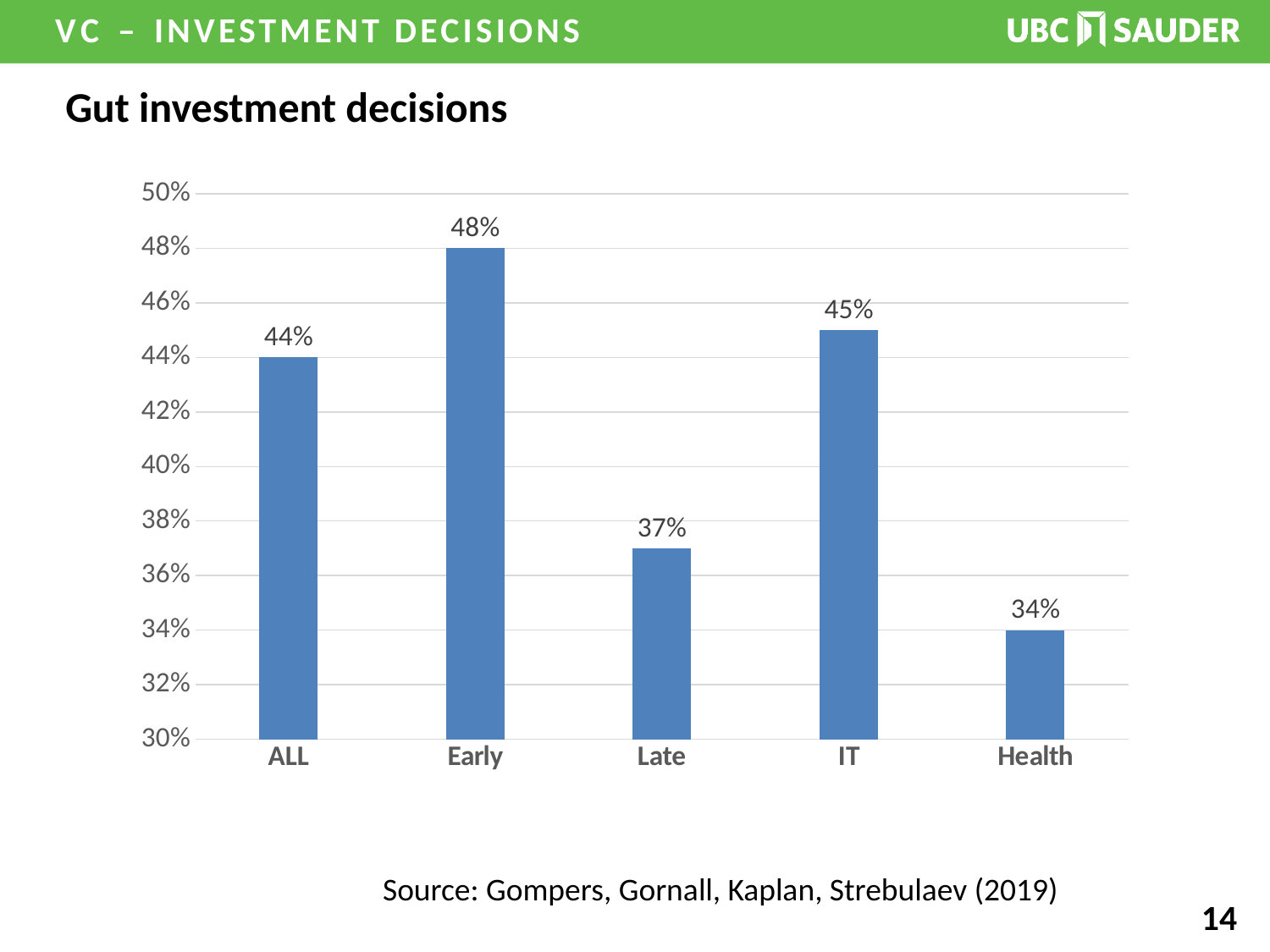
Which category has the lowest value? Health Is the value for Late greater or less than 40%? less How many categories are shown on the x axis? 5 What kind of chart is shown on the slide? bar chart What is the value for ALL? 44% Which is larger, the value for IT or the value for Late? IT What is the value for Early? 48% Which category has the highest value? Early What is the difference between the values for IT and Health? 11% What is the value for Health? 34% What is the difference between the values for Early and Late? 11% What is the title of the chart? Gut investment decisions